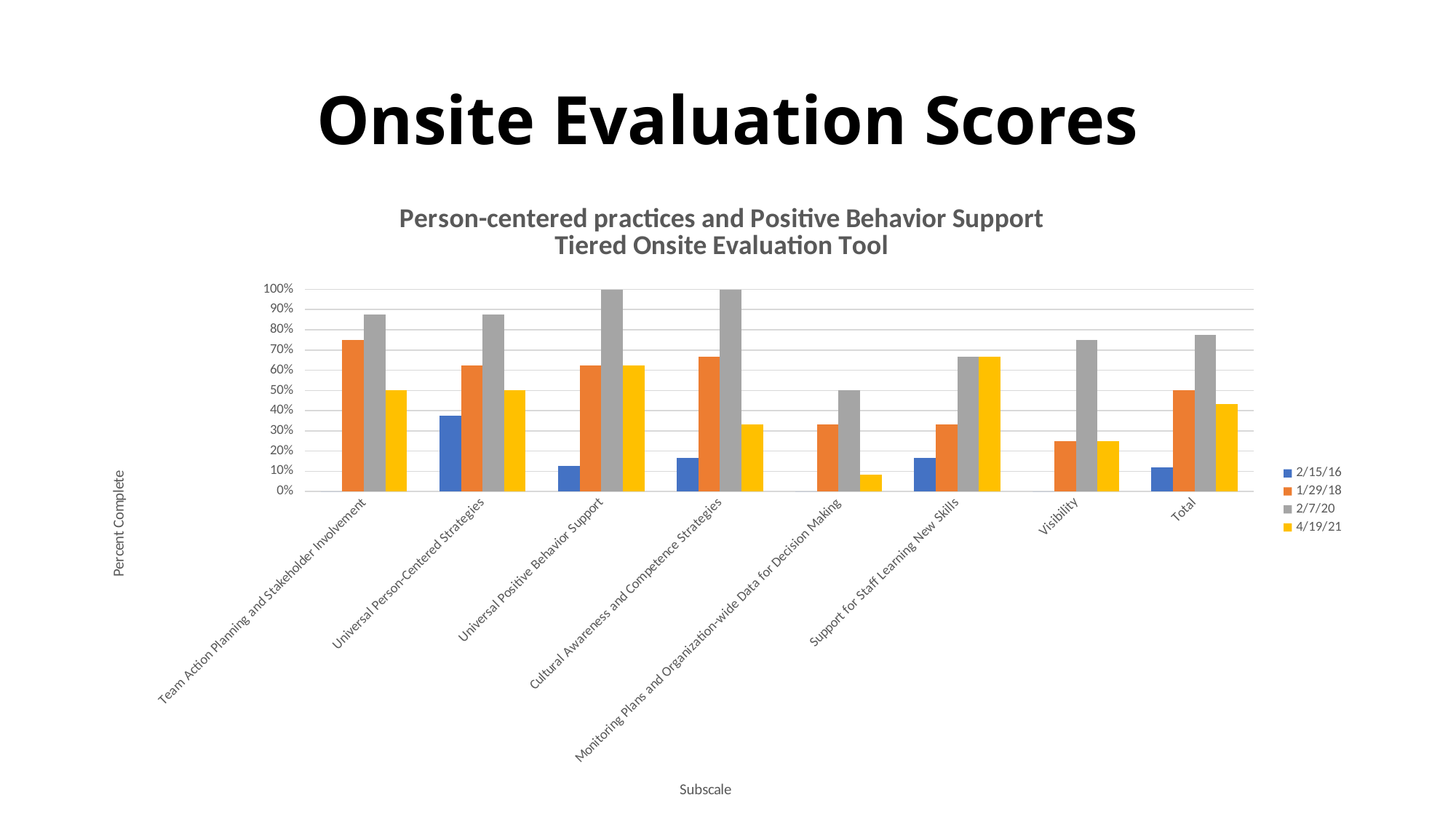
Which series has the highest value for Visibility? 2/7/20 What is the 1/29/18 value for Total? 50% How many series does the legend list? 4 What kind of chart is shown on the slide? bar chart Is the 4/19/21 value for Monitoring Plans and Organization-wide Data for Decision Making greater or less than 10%? less What is the 2/7/20 value for Cultural Awareness and Competence Strategies? 100% For Total, which is larger: the 2/7/20 value or the 4/19/21 value? 2/7/20 What is the label on the y axis? Percent Complete Is the 2/7/20 value for Visibility greater or less than 70%? greater How many subscale categories are shown on the x axis? 8 What is the 2/7/20 value for Monitoring Plans and Organization-wide Data for Decision Making? 50% What is the 2/7/20 value for Universal Positive Behavior Support? 100%